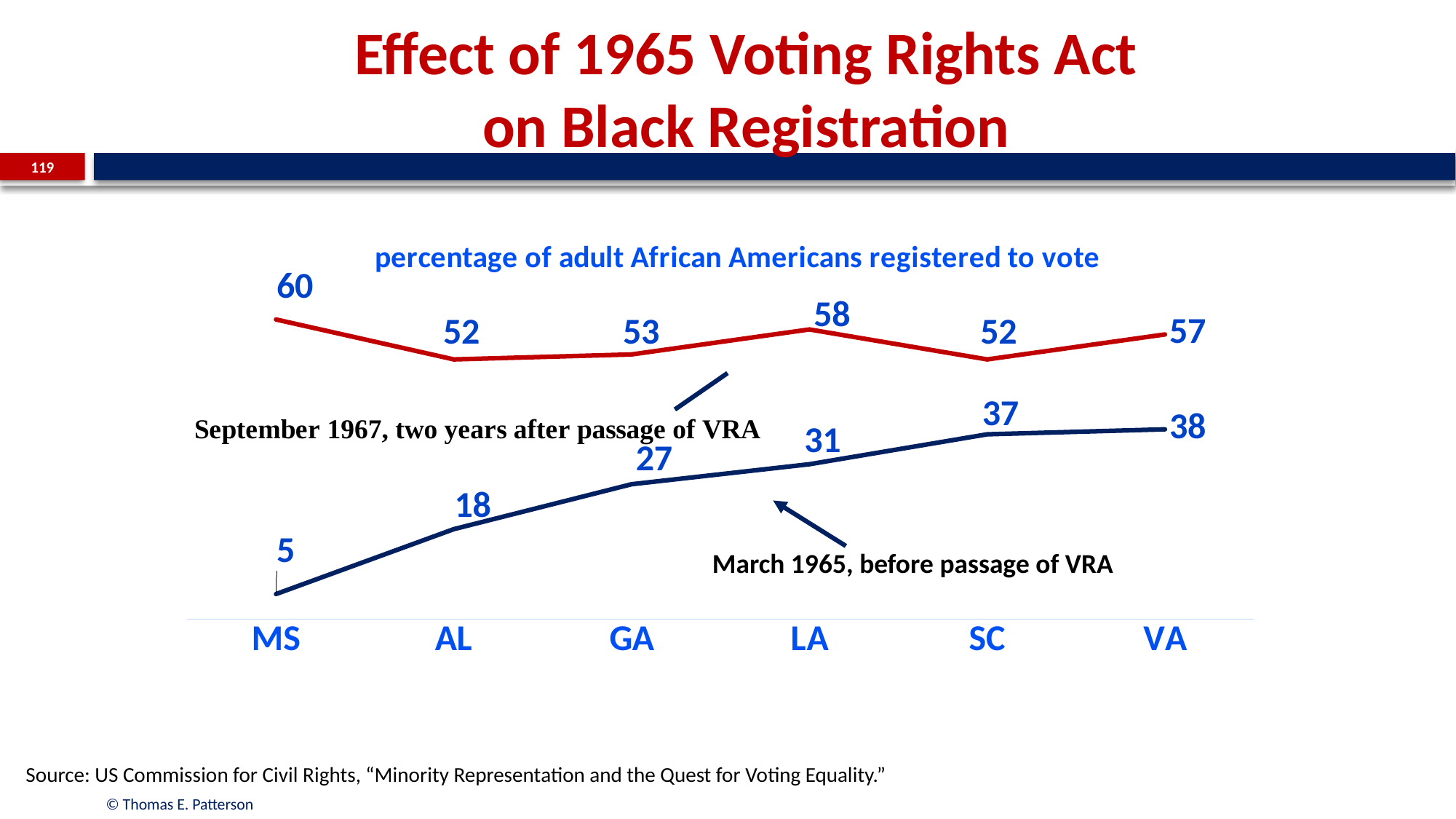
What is the difference between the September 1967 and March 1965 registration percentages for Virginia (VA)? 19 What was the percentage of adult African Americans registered to vote in Mississippi (MS) in September 1967, two years after passage of the VRA? 60 Which is larger: the March 1965 registration percentage for South Carolina (SC) or for Louisiana (LA)? SC What was the percentage of adult African Americans registered to vote in Mississippi (MS) in March 1965, before passage of the VRA? 5 What was the percentage of adult African Americans registered to vote in Louisiana (LA) in September 1967? 58 What is the difference between the September 1967 and March 1965 registration percentages for Mississippi (MS)? 55 Which state had the lowest percentage of adult African Americans registered to vote in March 1965? MS What type of chart is shown on the slide? Line chart What was the percentage of adult African Americans registered to vote in Georgia (GA) in March 1965? 27 Which state had the highest percentage of adult African Americans registered to vote in September 1967? MS How many states are shown on the x axis of the chart? 6 Which state had the highest percentage of adult African Americans registered to vote in March 1965? VA